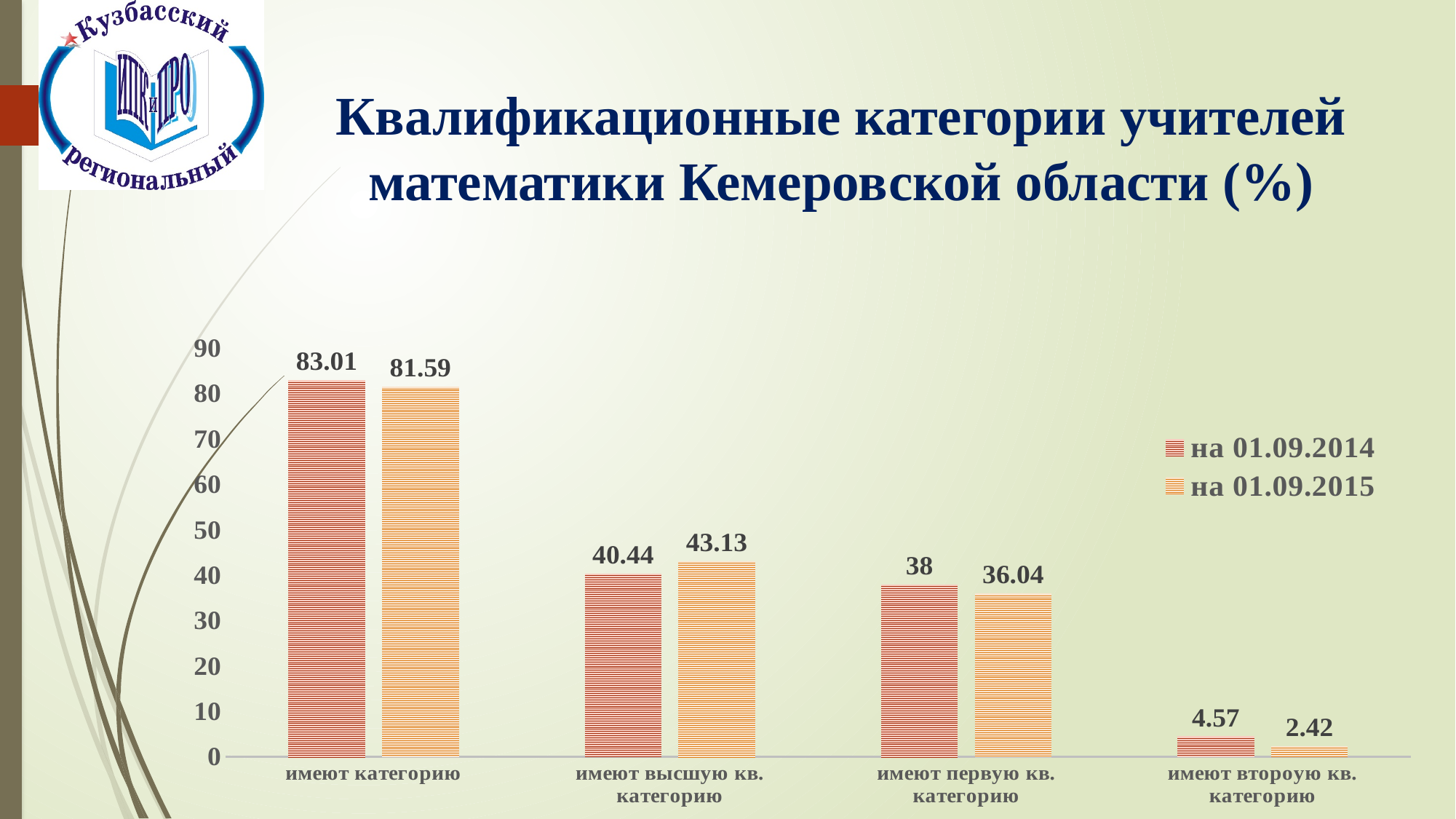
How many series does the legend list? 2 What is the difference between the "на 01.09.2014" and "на 01.09.2015" values for "имеют категорию"? 1.42 What is the value for "имеют вторую кв. категорию" in the "на 01.09.2015" series? 2.42 How many categories are shown on the x axis? 4 What is the value for "имеют первую кв. категорию" in the "на 01.09.2014" series? 38 Which category has the highest value in the "на 01.09.2015" series? имеют категорию What kind of chart is shown on the slide? bar chart Which category has the lowest value in the "на 01.09.2014" series? имеют второую кв. категорию What is the value for "имеют высшую кв. категорию" in the "на 01.09.2015" series? 43.13 What is the title of the chart on the slide? Квалификационные категории учителей математики Кемеровской области (%) For "имеют высшую кв. категорию", which series has the larger value: "на 01.09.2014" or "на 01.09.2015"? на 01.09.2015 What is the value for "имеют категорию" in the "на 01.09.2014" series? 83.01